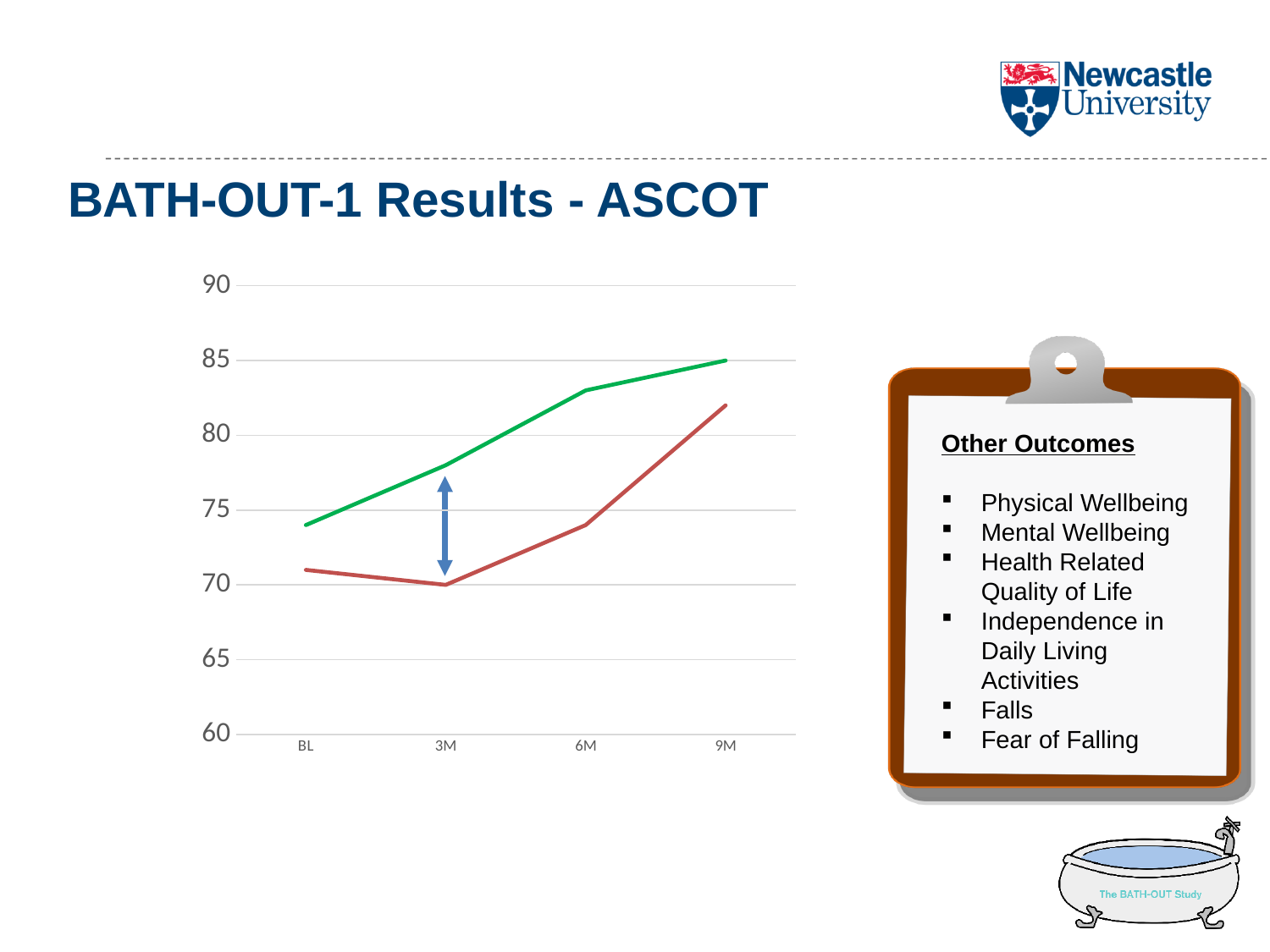
Does the green line rise or fall from BL to 9M? rise Is the value of the red line at 6M greater or less than 75? less Is the value of the green line at BL greater or less than 75? less Is the value of the red line at 9M greater or less than 80? greater How many lines are plotted on the chart? 2 What is the value of the red line at 3M? 70 At which time point does the red line reach its lowest value? 3M What kind of chart is shown on the slide? line chart How many time points are shown on the x axis of the chart? 4 What is the value of the green line at 9M? 85 At 3M, which line has the higher value, the green line or the red line? green line